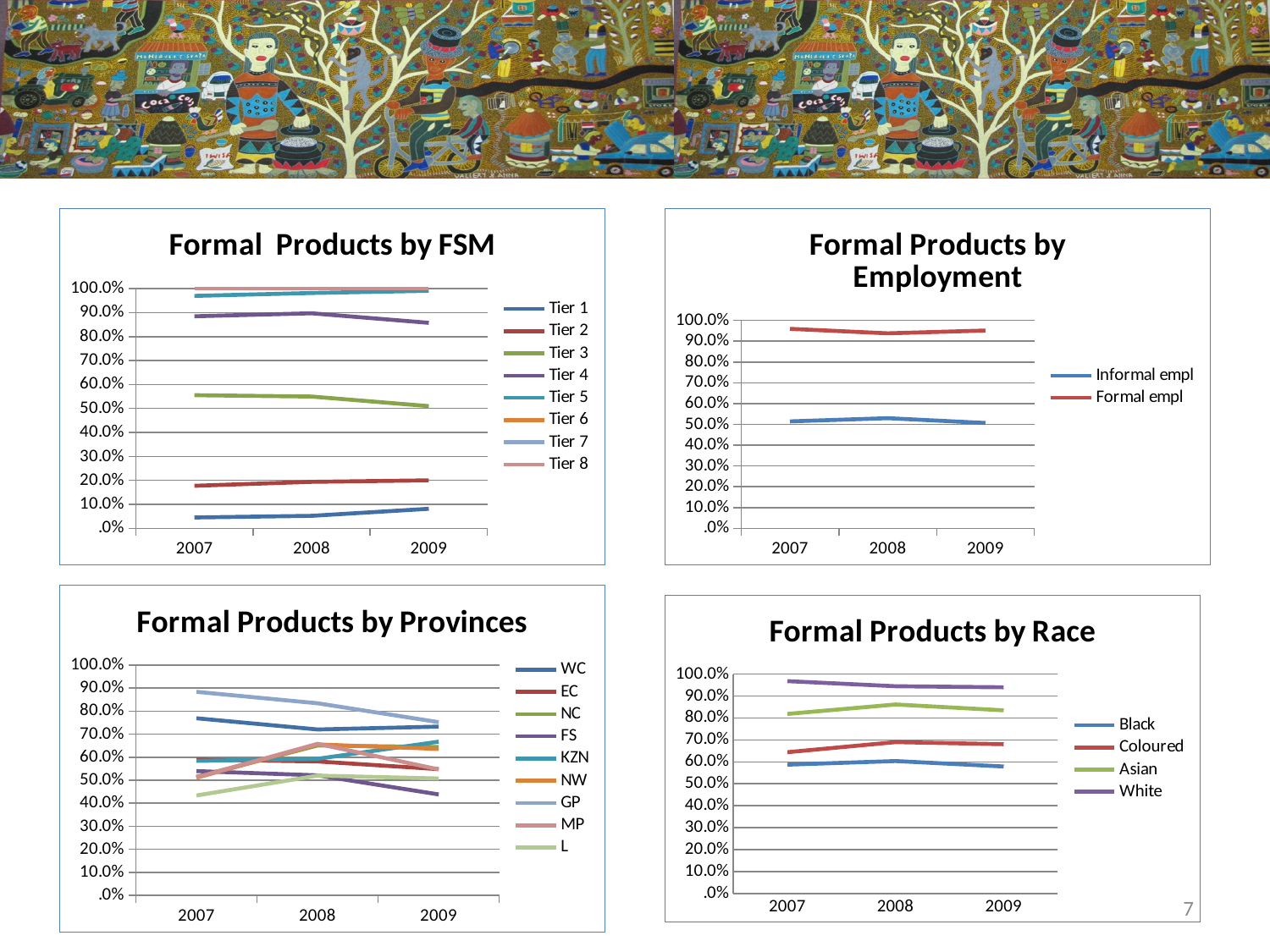
In the 'Formal Products by Provinces' chart, how many series does the legend list? 9 In the 'Formal Products by Employment' chart, how many series does the legend list? 2 In the 'Formal Products by FSM' chart, is the value for Tier 3 in 2007 greater or less than 50.0%? greater In the 'Formal Products by Employment' chart, is the value for Informal empl in 2007 greater or less than 60.0%? less What kind of chart is the 'Formal Products by FSM' chart? line chart In the 'Formal Products by Race' chart, which race group has the highest values across all years? White In the 'Formal Products by FSM' chart, how many series does the legend list? 8 In the 'Formal Products by Provinces' chart, which province has the highest value in 2007? GP In the 'Formal Products by Provinces' chart, how many years are shown on the x axis? 3 In the 'Formal Products by FSM' chart, which tier has the lowest value in 2009? Tier 1 In the 'Formal Products by Employment' chart, which is larger in 2008: Informal empl or Formal empl? Formal empl In the 'Formal Products by Race' chart, is the value for Black in 2009 greater or less than 70.0%? less